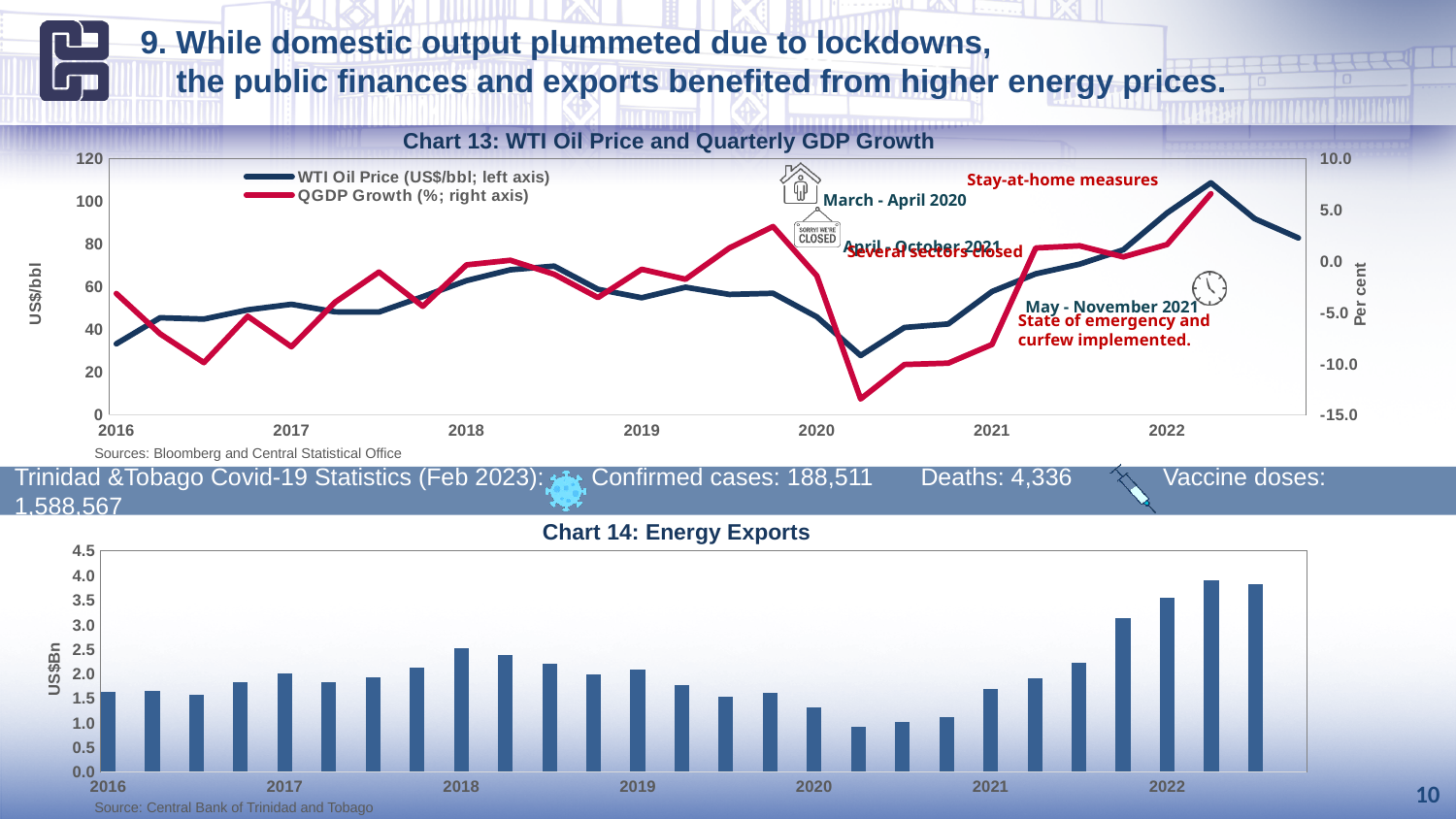
What kind of chart is Chart 14: Energy Exports? Bar chart What is the unit shown on the y axis of Chart 14? US$Bn What kind of chart is Chart 13: WTI Oil Price and Quarterly GDP Growth? Line chart In Chart 14, is the value of the first bar of 2018 greater or less than 2.0? greater In Chart 13, is the peak WTI Oil Price reached in 2022 greater or less than 100? greater In Chart 14, is the tallest bar in 2022 greater or less than 3.5? greater How many series does the legend of Chart 13 list? 2 In Chart 14, which is larger: the first bar of 2018 or the first bar of 2016? First bar of 2018 In Chart 14, do energy exports rise or fall from the 2020 low to 2022? Rise